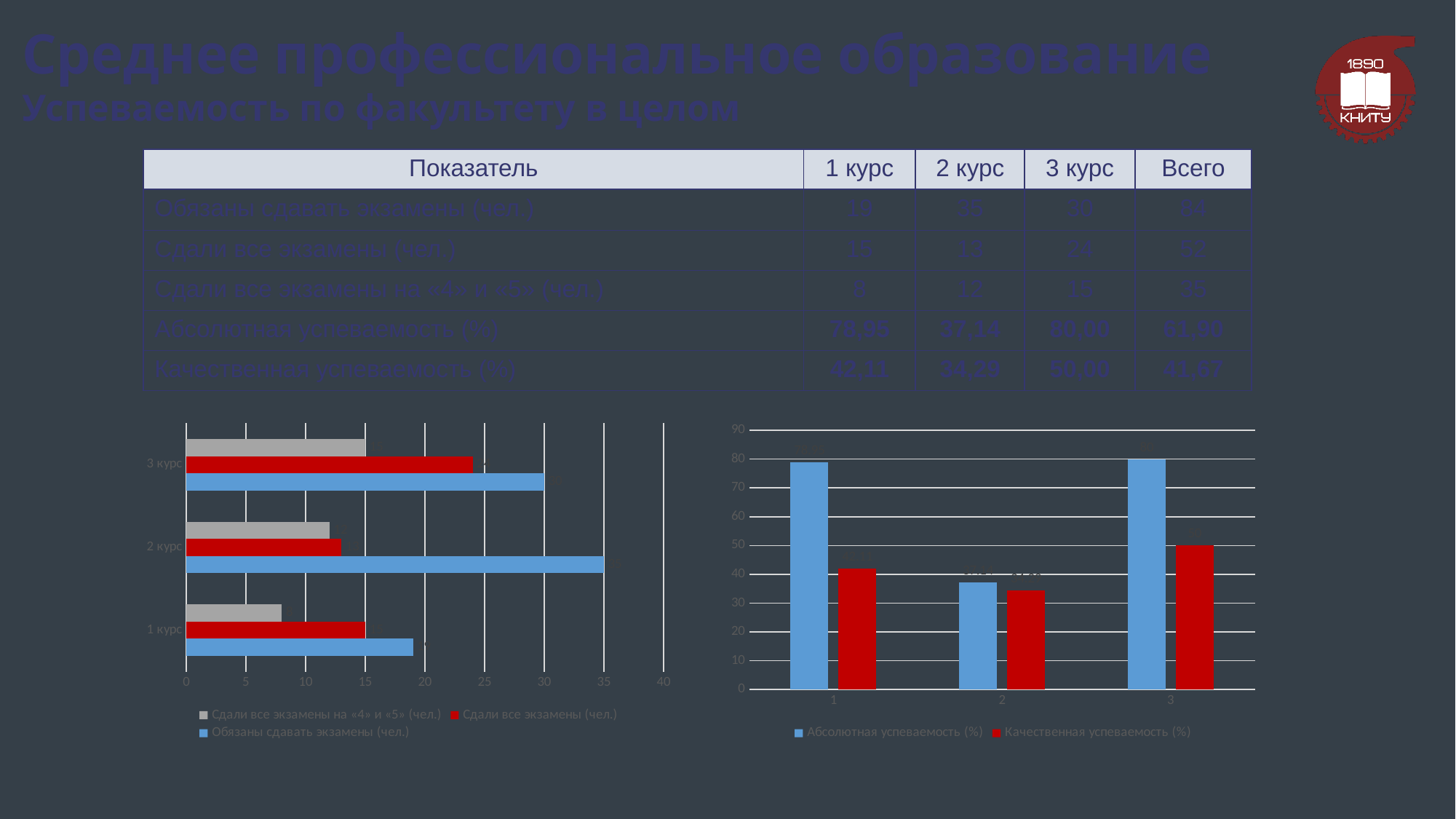
On the right chart, which category has the lowest 'Абсолютная успеваемость (%)' value? 2 On the left chart, what is the difference between the 'Обязаны сдавать экзамены (чел.)' values for 2 курс and 3 курс? 5 On the left chart, what is the value of the 'Обязаны сдавать экзамены (чел.)' bar for 2 курс? 35 On the right chart, is the 'Абсолютная успеваемость (%)' value for category 2 greater or less than 40? less On the left chart, what is the value of the 'Обязаны сдавать экзамены (чел.)' bar for 3 курс? 30 On the right chart, what is the value of 'Качественная успеваемость (%)' for category 3? 50 On the left chart, what is the value of the 'Сдали все экзамены (чел.)' bar for 1 курс? 15 On the right chart, for category 1, which is larger: 'Абсолютная успеваемость (%)' or 'Качественная успеваемость (%)'? Абсолютная успеваемость (%) On the left chart, which course has the highest 'Обязаны сдавать экзамены (чел.)' value? 2 курс On the left chart, is the 'Обязаны сдавать экзамены (чел.)' value for 1 курс greater or less than 15? greater How many series does the legend of the left chart list? 3 On the right chart, what is the value of 'Абсолютная успеваемость (%)' for category 3? 80